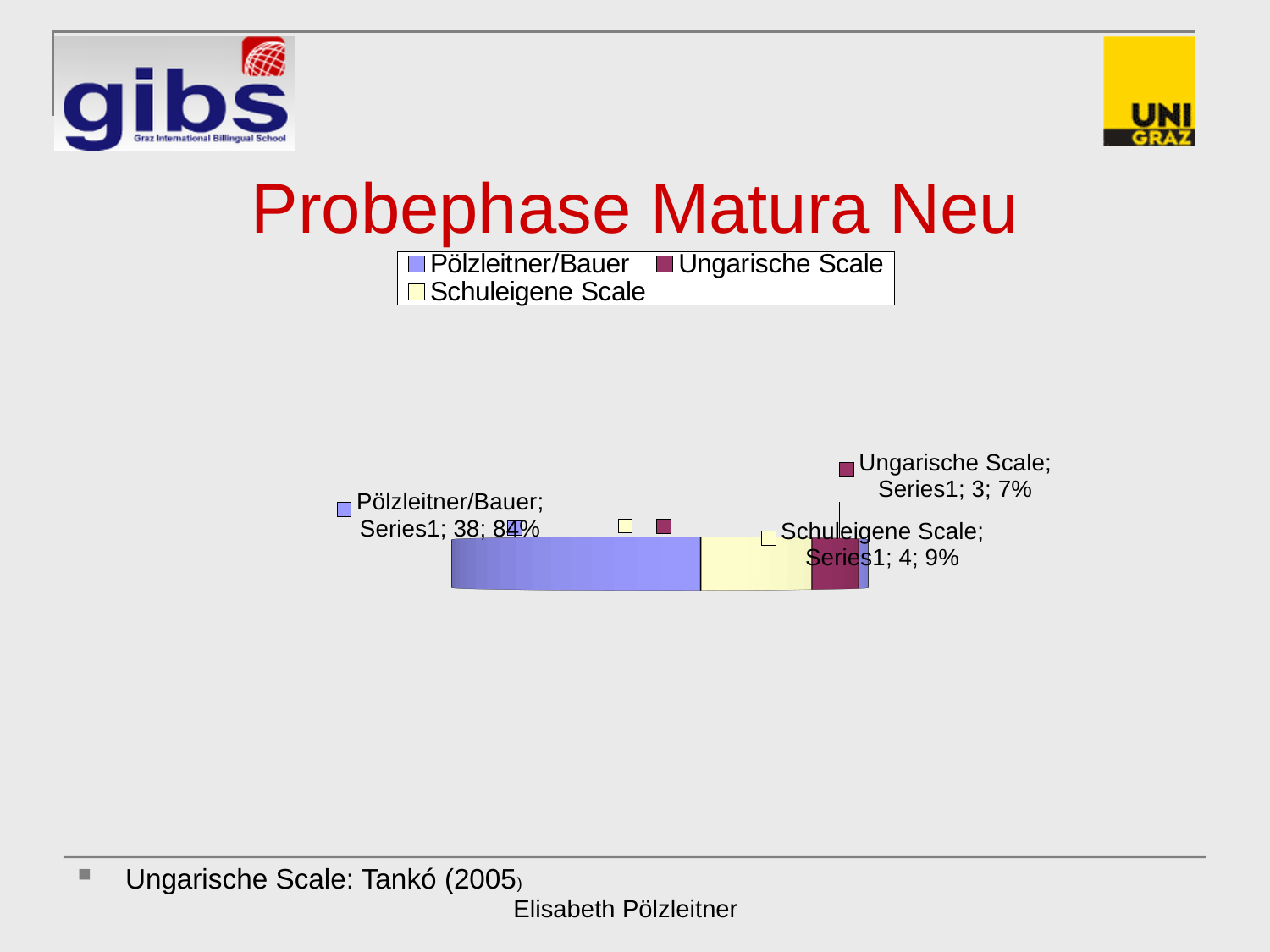
What is the value for Schuleigene Scale? 4 What kind of chart is shown on the slide? pie chart Which category has the smallest slice? Ungarische Scale Which category has the largest slice? Pölzleitner/Bauer What share of the pie does Pölzleitner/Bauer have? 84% What is the difference between the values for Pölzleitner/Bauer and Schuleigene Scale? 34 What is the value for Ungarische Scale? 3 What share of the pie does Ungarische Scale have? 7% What share of the pie does Schuleigene Scale have? 9% How many categories does the pie chart have? 3 Which is larger, Schuleigene Scale or Ungarische Scale? Schuleigene Scale What is the value for Pölzleitner/Bauer? 38